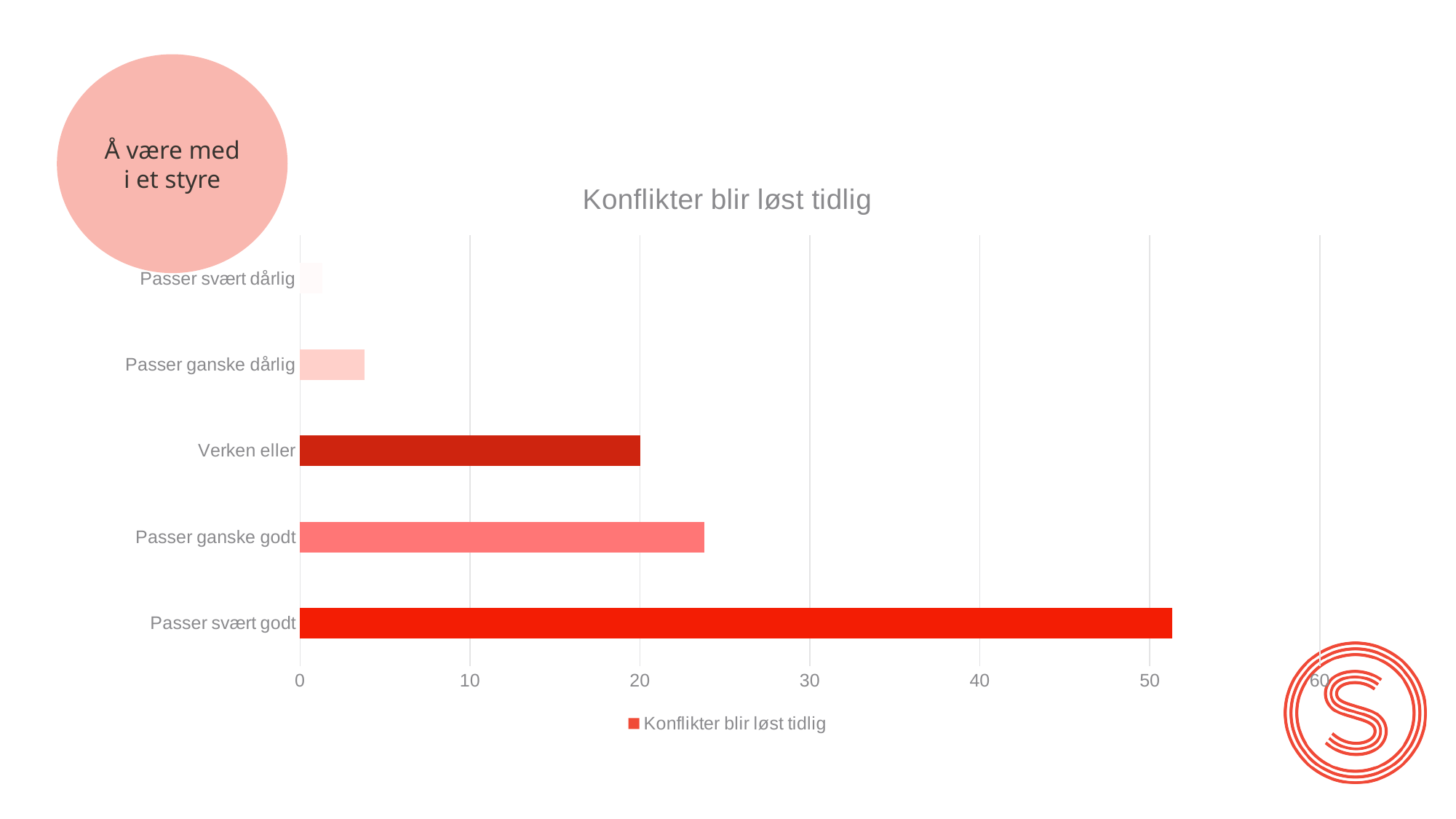
How many categories are shown on the chart? 5 Which is larger, the value for Passer ganske dårlig or the value for Passer svært dårlig? Passer ganske dårlig Is the value for Passer ganske godt greater or less than 20? greater Which category has the lowest value? Passer svært dårlig Is the value for Passer ganske dårlig greater or less than 10? less Is the value for Passer svært godt greater or less than 50? greater What is the title of the chart? Konflikter blir løst tidlig What kind of chart is shown on the slide? bar chart Which is larger, the value for Passer ganske godt or the value for Verken eller? Passer ganske godt How many series does the legend list? 1 Which category has the highest value? Passer svært godt